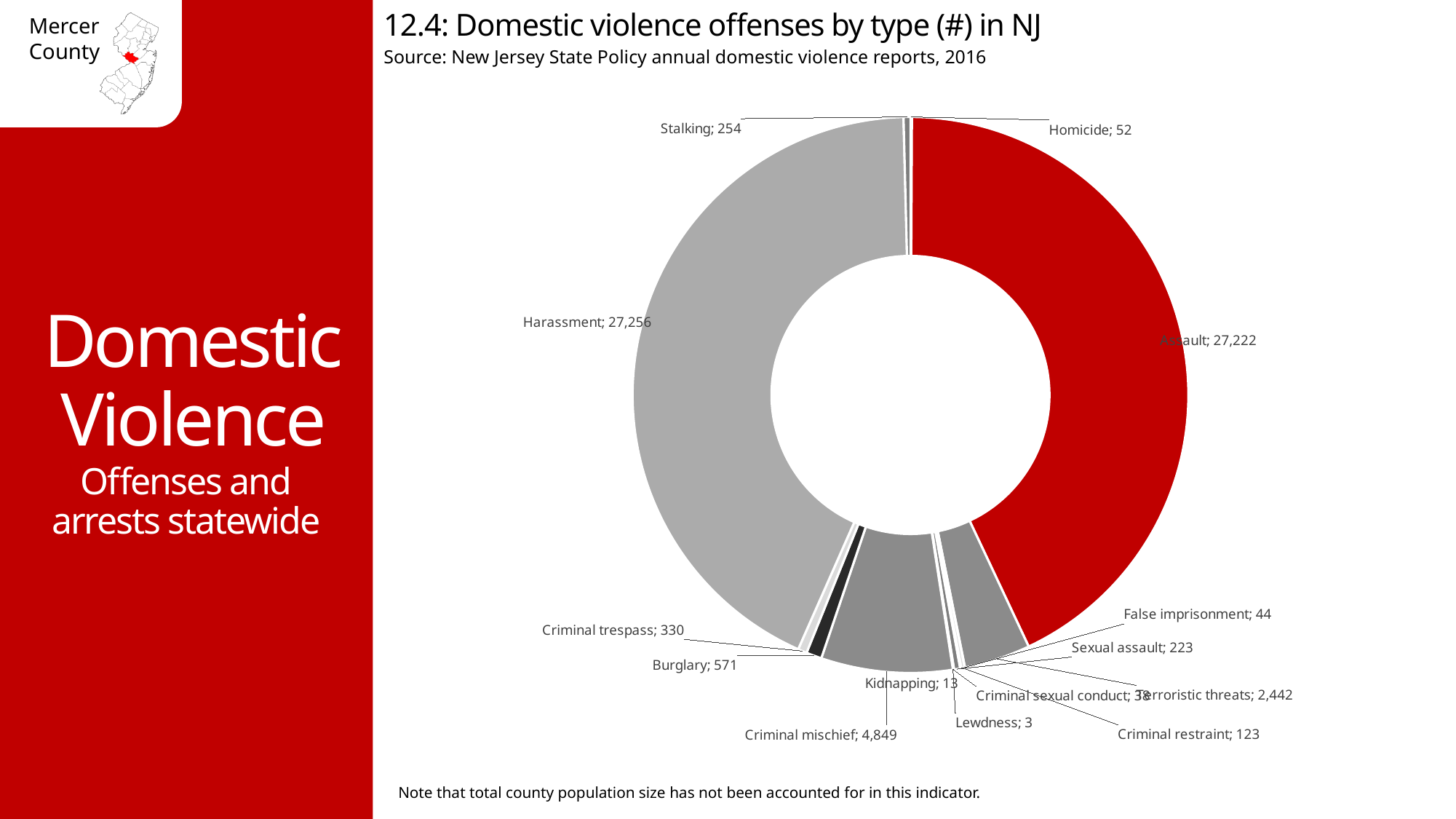
What value is shown for Terroristic threats? 2,442 How many offense types are shown on the chart? 14 What is the number of Harassment offenses shown on the chart? 27,256 What is the number of Assault offenses shown on the chart? 27,222 What value is shown for Criminal mischief? 4,849 Which offense type has the highest number of offenses? Harassment What is the difference between the Harassment and Assault values? 34 What kind of chart is shown on the slide? doughnut chart Which offense type has the lowest number of offenses? Lewdness What is the difference between the Burglary and Criminal trespass values? 241 Which is larger, the value for Homicide or the value for False imprisonment? Homicide What value is shown for Homicide? 52